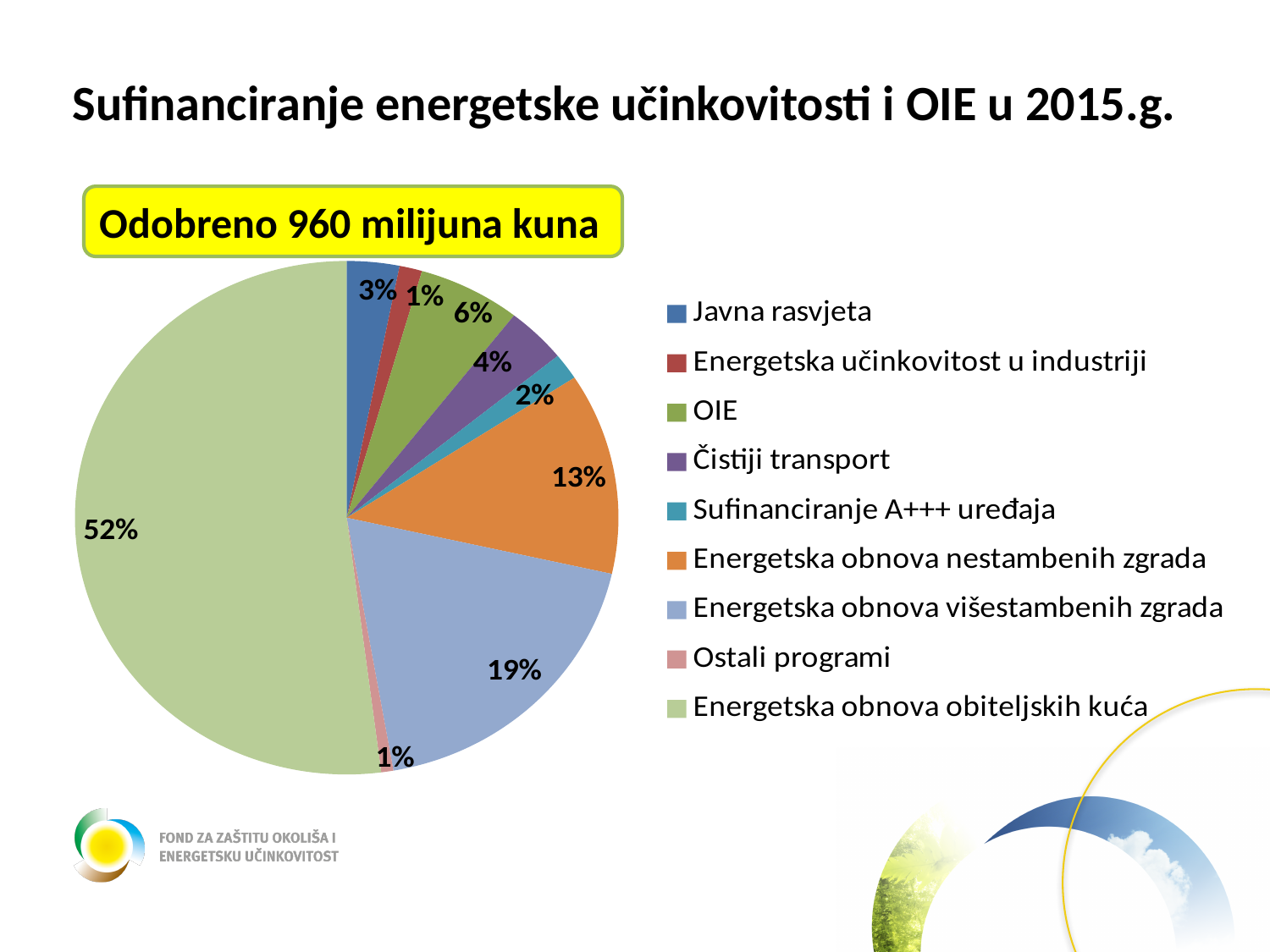
Which is larger, the slice for Čistiji transport or the slice for Sufinanciranje A+++ uređaja? Čistiji transport How many categories does the legend list? 9 What share of the pie does Energetska obnova višestambenih zgrada have? 19% What total amount is stated in the yellow box above the chart? Odobreno 960 milijuna kuna What share of the pie does Energetska obnova obiteljskih kuća have? 52% Which category has the largest slice of the pie? Energetska obnova obiteljskih kuća What is the title of the slide? Sufinanciranje energetske učinkovitosti i OIE u 2015.g. What type of chart is shown on the slide? Pie chart What is the difference in percentage points between Energetska obnova višestambenih zgrada and Energetska obnova nestambenih zgrada? 6 percentage points What share of the pie does Javna rasvjeta have? 3%